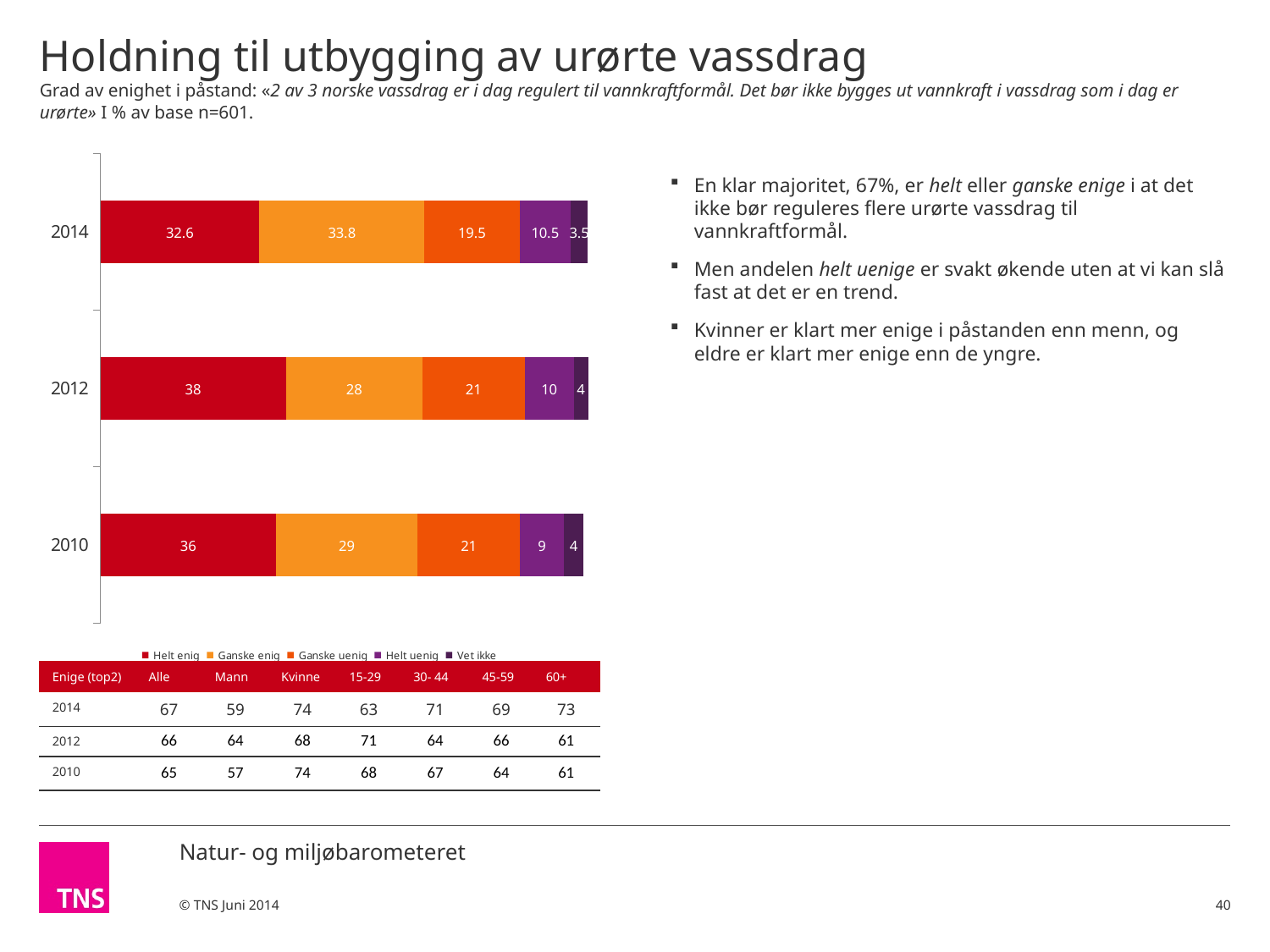
Which year has the highest value for Helt enig? 2012 What is the value for Helt enig in 2014? 32.6 What is the value for Ganske uenig in 2010? 21 What is the total of the stacked bar for 2012? 101 What is the value for Helt uenig in 2014? 10.5 Which year has the lowest value for Helt uenig? 2010 How many series does the chart legend list? 5 What is the difference between the Helt enig values for 2012 and 2010? 2 What kind of chart is shown on the slide? stacked bar chart What is the value for Ganske enig in 2012? 28 How many years (categories) are plotted in the chart? 3 Is the Ganske enig value larger in 2014 or in 2010? 2014